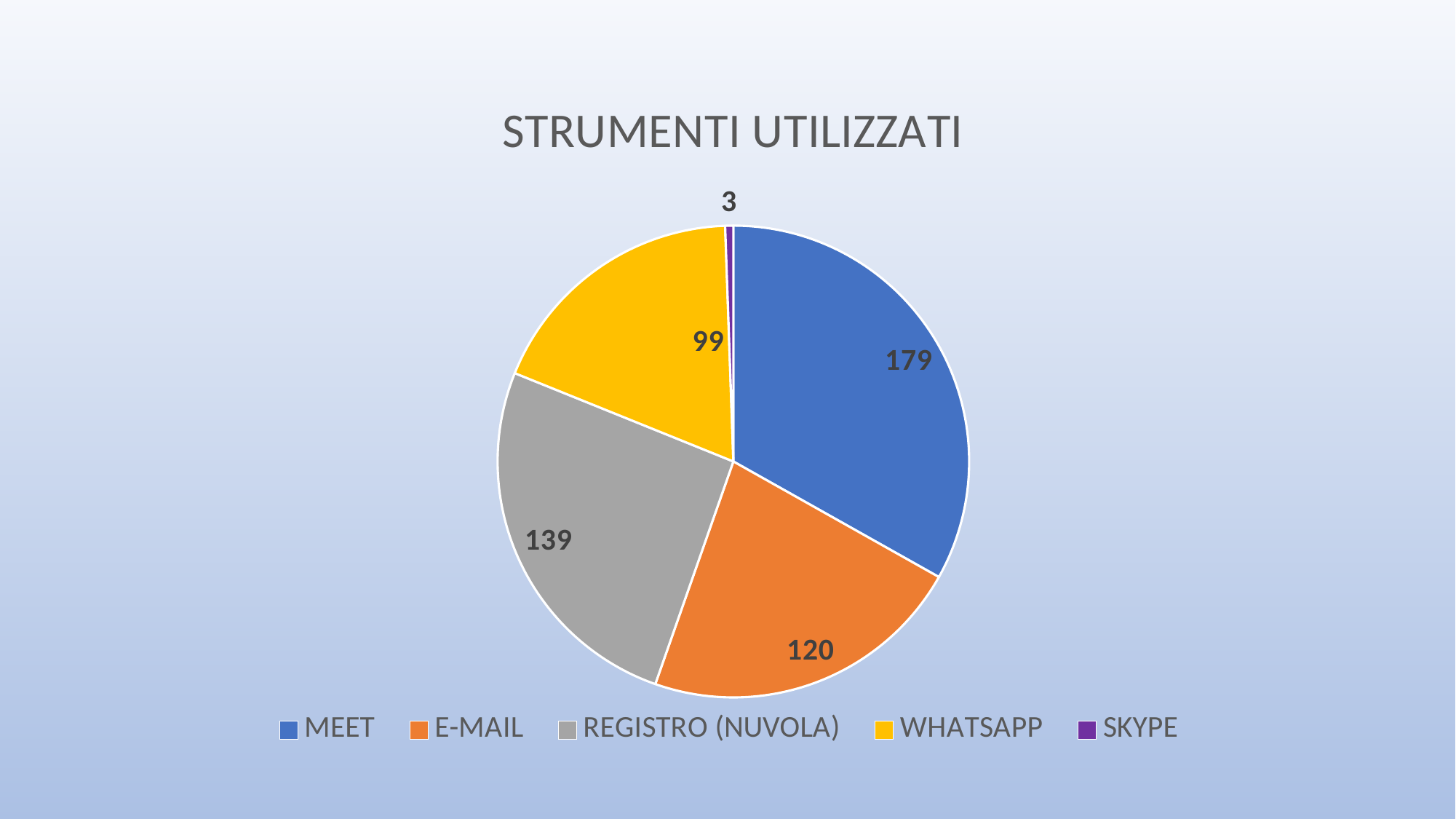
What is the value for E-MAIL? 120 Which category has the smallest slice? SKYPE What is the difference between the values for MEET and E-MAIL? 59 How many categories does the pie chart show? 5 What is the value for REGISTRO (NUVOLA)? 139 What is the value for WHATSAPP? 99 What is the value for SKYPE? 3 What is the title of the chart? STRUMENTI UTILIZZATI What is the value for MEET? 179 What type of chart is shown on the slide? pie chart Which category has the largest slice? MEET Which is larger, REGISTRO (NUVOLA) or WHATSAPP? REGISTRO (NUVOLA)